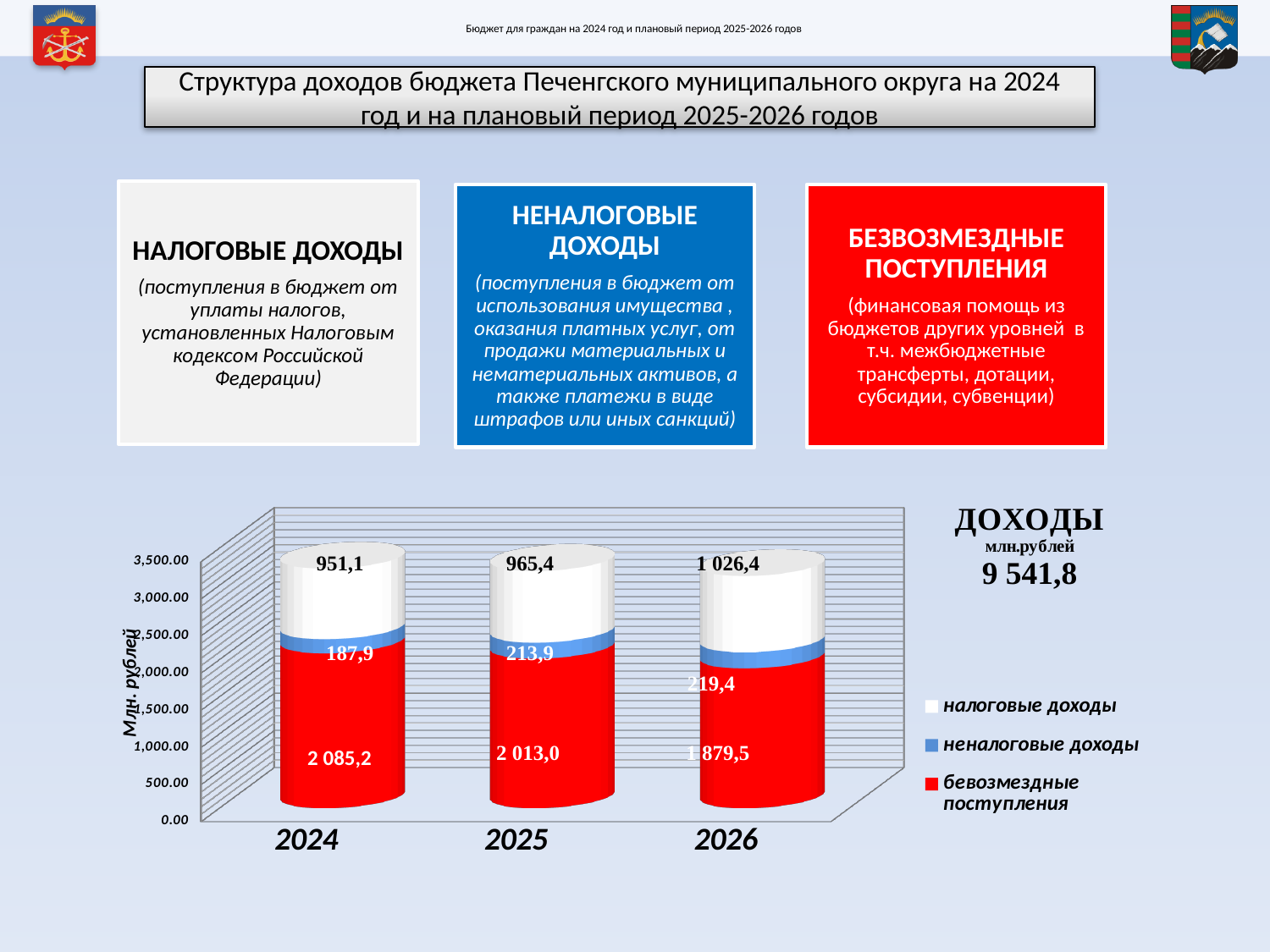
What is the value of неналоговые доходы for 2025? 213,9 Do the values of налоговые доходы rise or fall from 2024 to 2026? rise What is the value of налоговые доходы for 2024? 951,1 How many series does the chart legend list? 3 What kind of chart is shown on the slide? stacked bar chart Which is larger: безвозмездные поступления in 2025 or in 2026? 2025 How many years are shown on the x axis of the chart? 3 In which year is the value of безвозмездные поступления the highest? 2024 In which year is the value of неналоговые доходы the lowest? 2024 What is the total of the stacked bar for 2024? 3 224,2 What is the value of безвозмездные поступления for 2026? 1 879,5 What is the difference between налоговые доходы in 2026 and in 2024? 75,3